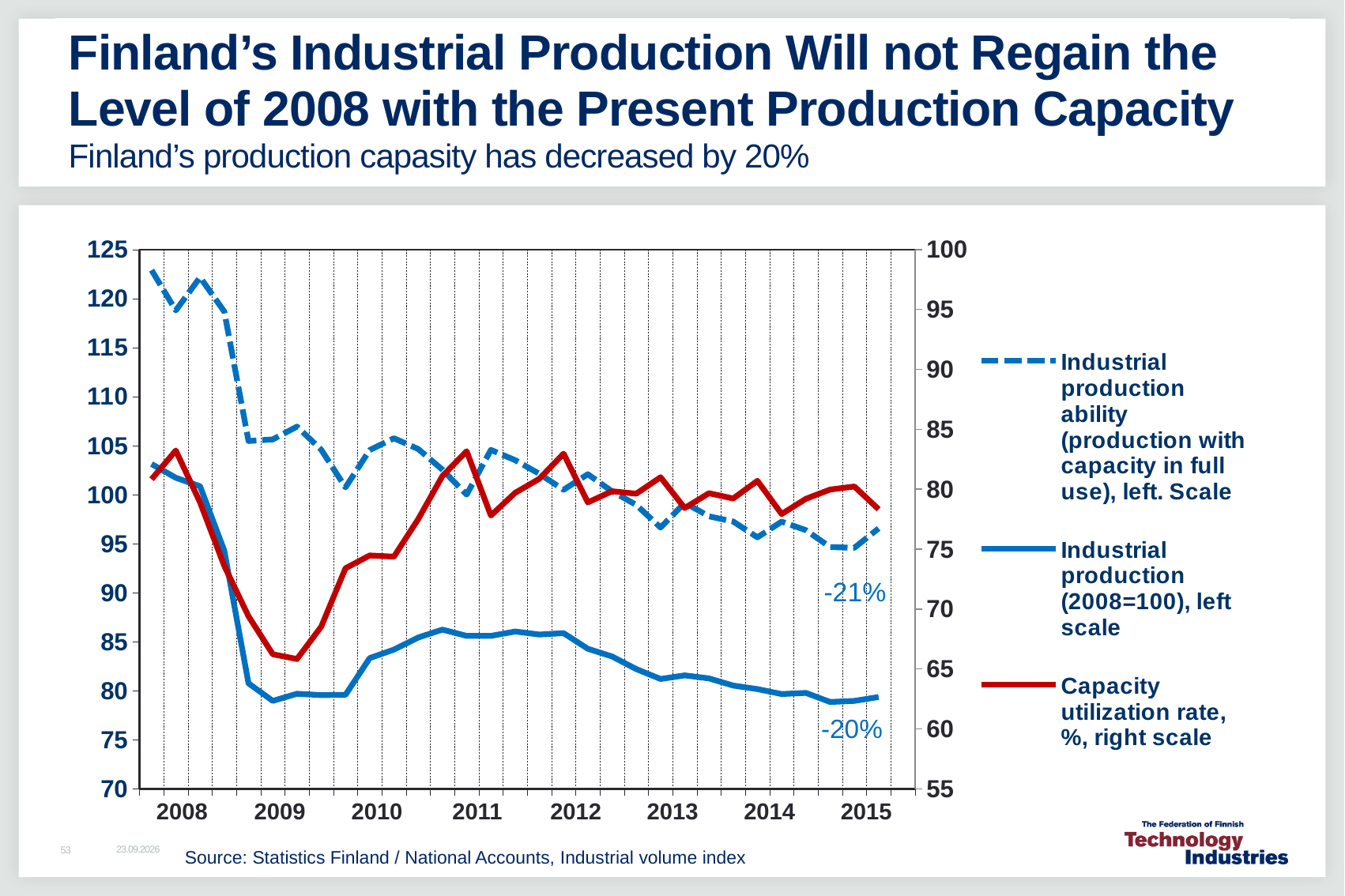
In 2015, which is higher: Industrial production ability or Industrial production (2008=100)? Industrial production ability What kind of chart is shown on the slide? line chart Is the value of Industrial production ability at the start of 2008 greater or less than 115 on the left scale? greater How many years are labelled on the x axis? 8 Is the value of Industrial production (2008=100) in 2015 greater or less than 85 on the left scale? less How many series does the legend list? 3 Does Industrial production (2008=100) rise or fall overall from 2008 to 2015? fall What percentage change is annotated next to the Industrial production (2008=100) line at the end of the chart? -20% Is the Capacity utilization rate at its 2009 low greater or less than 70 on the right scale? less Which series is plotted on the right scale? Capacity utilization rate, % In which year does the Capacity utilization rate reach its lowest point? 2009